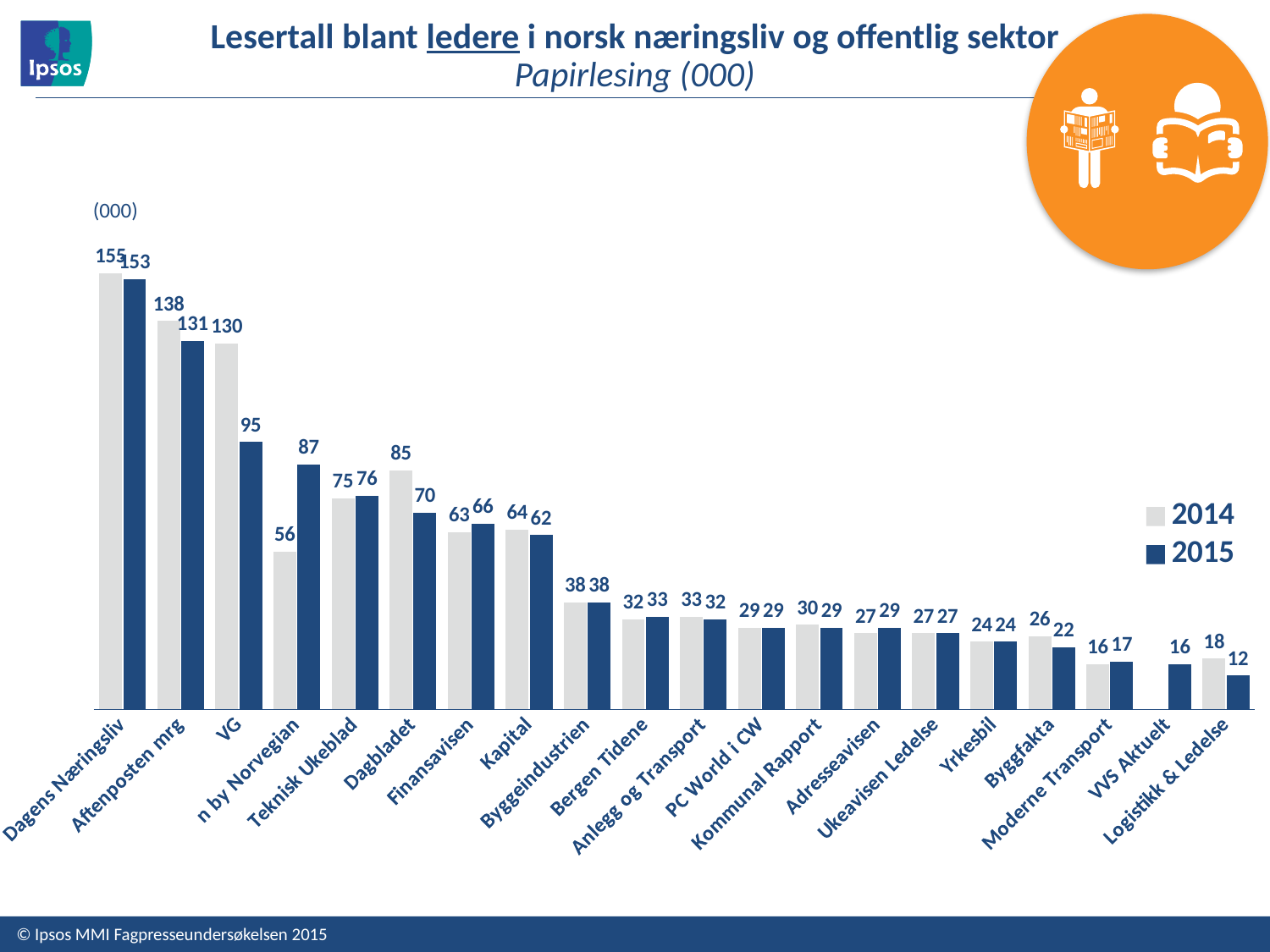
How many categories are shown on the x axis? 20 What is the 2014 value for VG? 130 What is the 2015 value for Dagens Næringsliv? 153 What is the difference between the 2014 and 2015 values for VG? 35 How many series does the legend list? 2 Which is larger for Dagbladet, the 2014 value or the 2015 value? 2014 Which category has the lowest 2015 value? Logistikk & Ledelse What are the two series listed in the legend? 2014 and 2015 Which is larger for n by Norvegian, the 2014 value or the 2015 value? 2015 What kind of chart is shown on the slide? Bar chart What is the 2015 value for n by Norvegian? 87 Which category has the highest 2014 value? Dagens Næringsliv